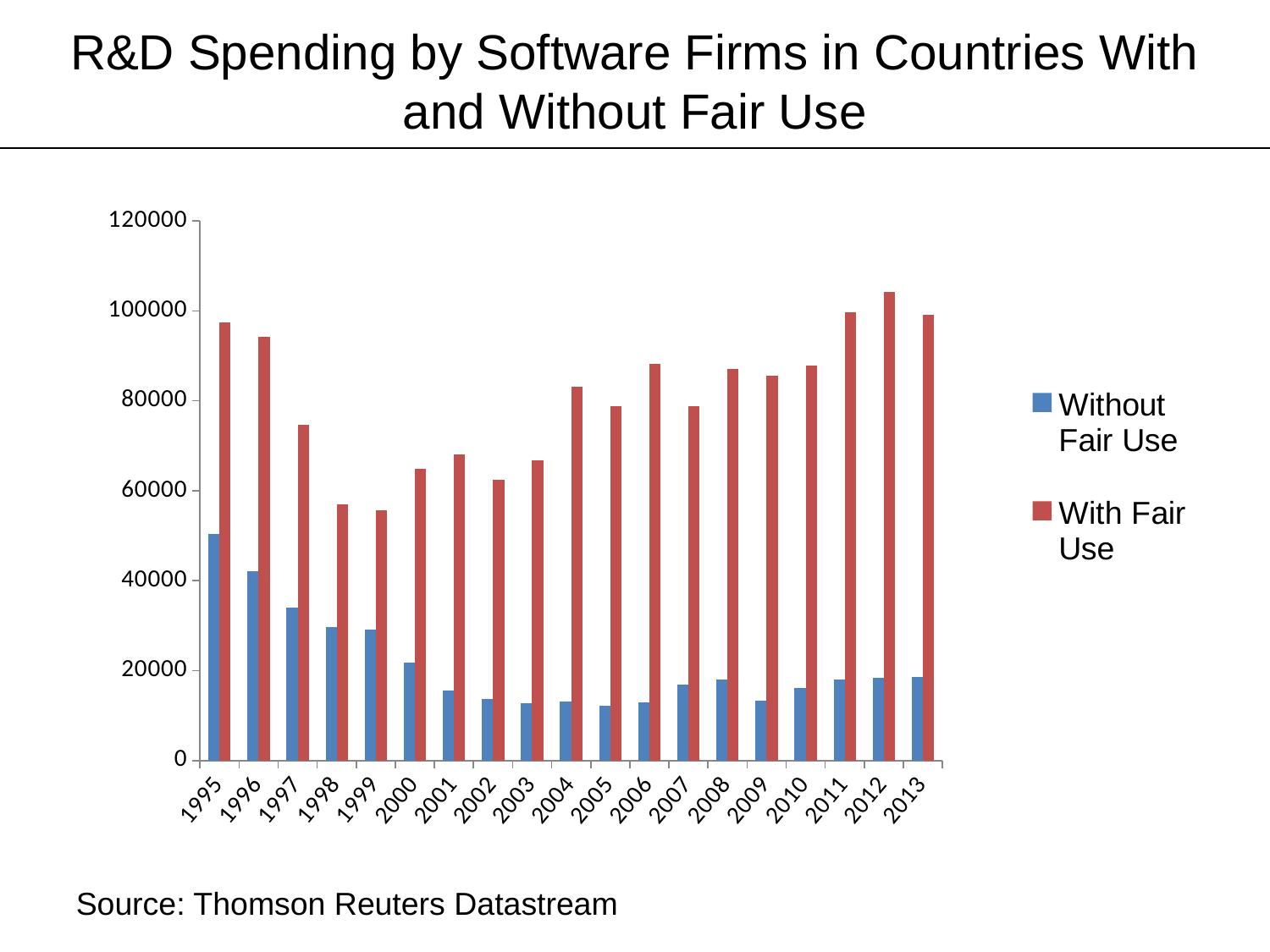
Which is larger, the Without Fair Use value for 1996 or for 1997? 1996 How many series does the legend list? 2 Is the Without Fair Use value for 1995 greater or less than 40000? greater What is the source cited below the chart? Thomson Reuters Datastream In which year is the Without Fair Use value highest? 1995 Is the Without Fair Use value for 2001 greater or less than 20000? less In which year is the With Fair Use value highest? 2012 How many years are shown on the x axis? 19 Is the With Fair Use value for 2012 greater or less than 100000? greater Does the Without Fair Use series rise or fall from 1995 to 2000? Fall What kind of chart is shown on the slide? Bar chart